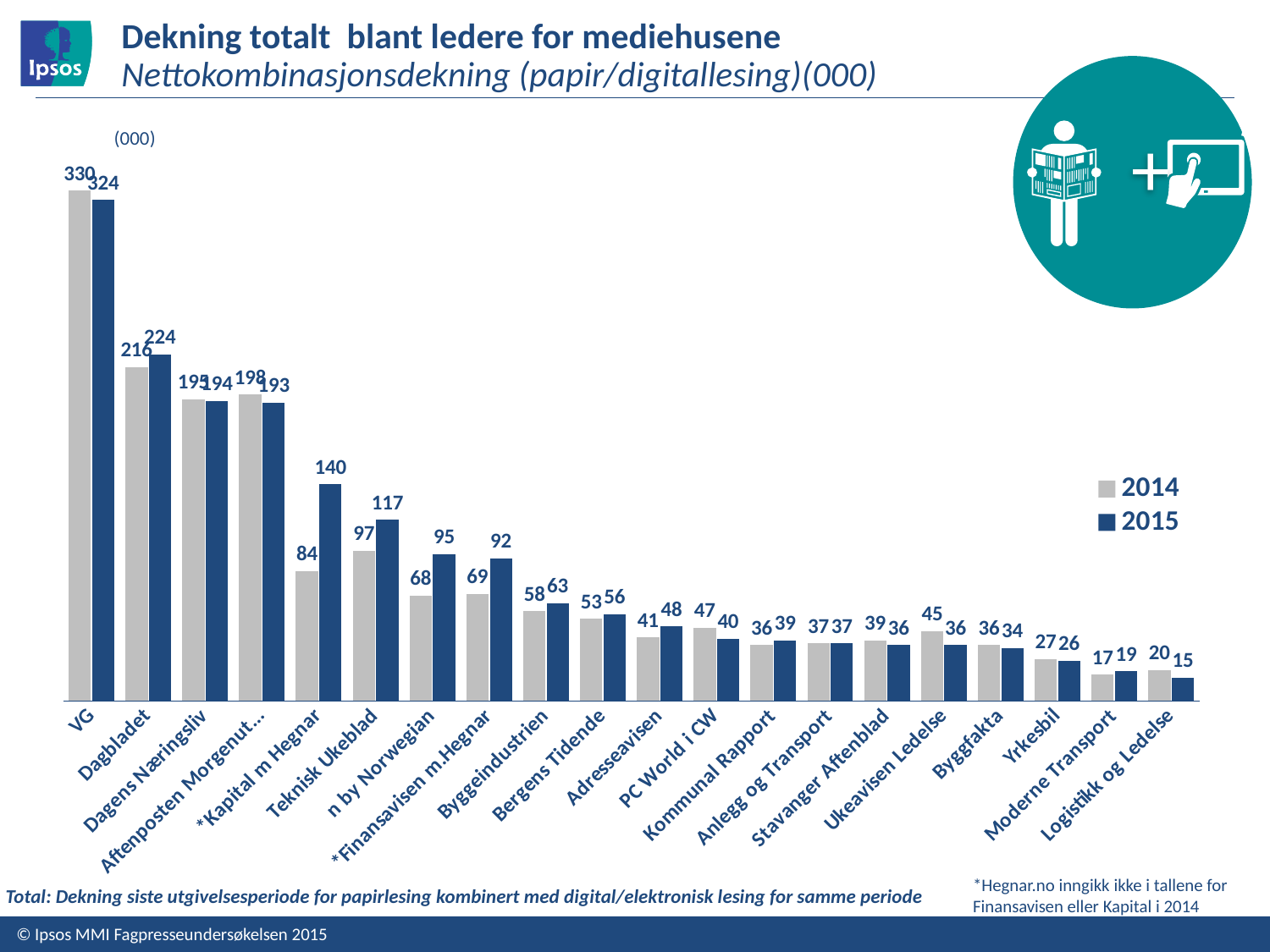
What is the 2014 value for Teknisk Ukeblad? 97 What kind of chart is shown on the slide? Bar chart Which is larger for n by Norwegian, the 2014 value or the 2015 value? 2015 What is the difference between the 2014 and 2015 values for Dagbladet? 8 Which category has the highest 2014 value? VG What is the difference between the 2015 and 2014 values for *Kapital m Hegnar? 56 How many series does the legend list? 2 What is the 2015 value for *Kapital m Hegnar? 140 What is the 2015 value for VG? 324 Which is larger for Ukeavisen Ledelse, the 2014 value or the 2015 value? 2014 Which category has the lowest 2015 value? Logistikk og Ledelse How many categories are shown on the x axis? 20